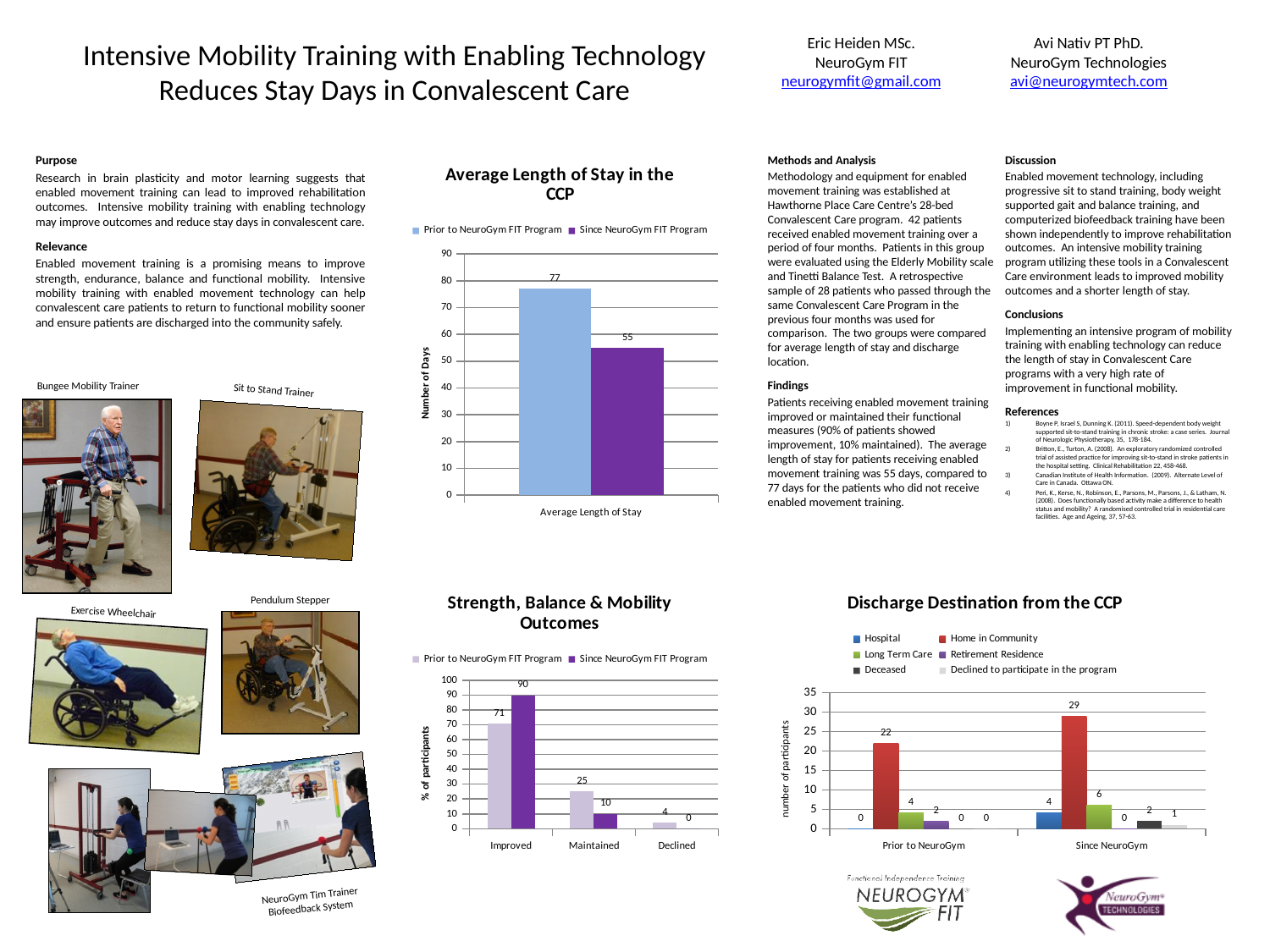
In the 'Discharge Destination from the CCP' chart, how many series does the legend list? 6 In the 'Strength, Balance & Mobility Outcomes' chart, what percentage of participants improved since the NeuroGym FIT Program? 90 In the 'Strength, Balance & Mobility Outcomes' chart, what is the value for 'Maintained' prior to the NeuroGym FIT Program? 25 What type of chart is 'Discharge Destination from the CCP'? Bar chart In the 'Average Length of Stay in the CCP' chart, what is the average length of stay for the 'Since NeuroGym FIT Program' series? 55 In the 'Average Length of Stay in the CCP' chart, what is the average length of stay for the 'Prior to NeuroGym FIT Program' series? 77 In the 'Strength, Balance & Mobility Outcomes' chart, how many categories are shown on the x axis? 3 In the 'Average Length of Stay in the CCP' chart, what is the label of the vertical axis? Number of Days In the 'Discharge Destination from the CCP' chart, how many participants were discharged to 'Home in Community' since NeuroGym? 29 In the 'Strength, Balance & Mobility Outcomes' chart, which category has the lowest value for the 'Since NeuroGym FIT Program' series? Declined In the 'Discharge Destination from the CCP' chart, which series has the highest value for 'Prior to NeuroGym'? Home in Community In the 'Average Length of Stay in the CCP' chart, what is the difference in days between the 'Prior' and 'Since' NeuroGym FIT Program bars? 22